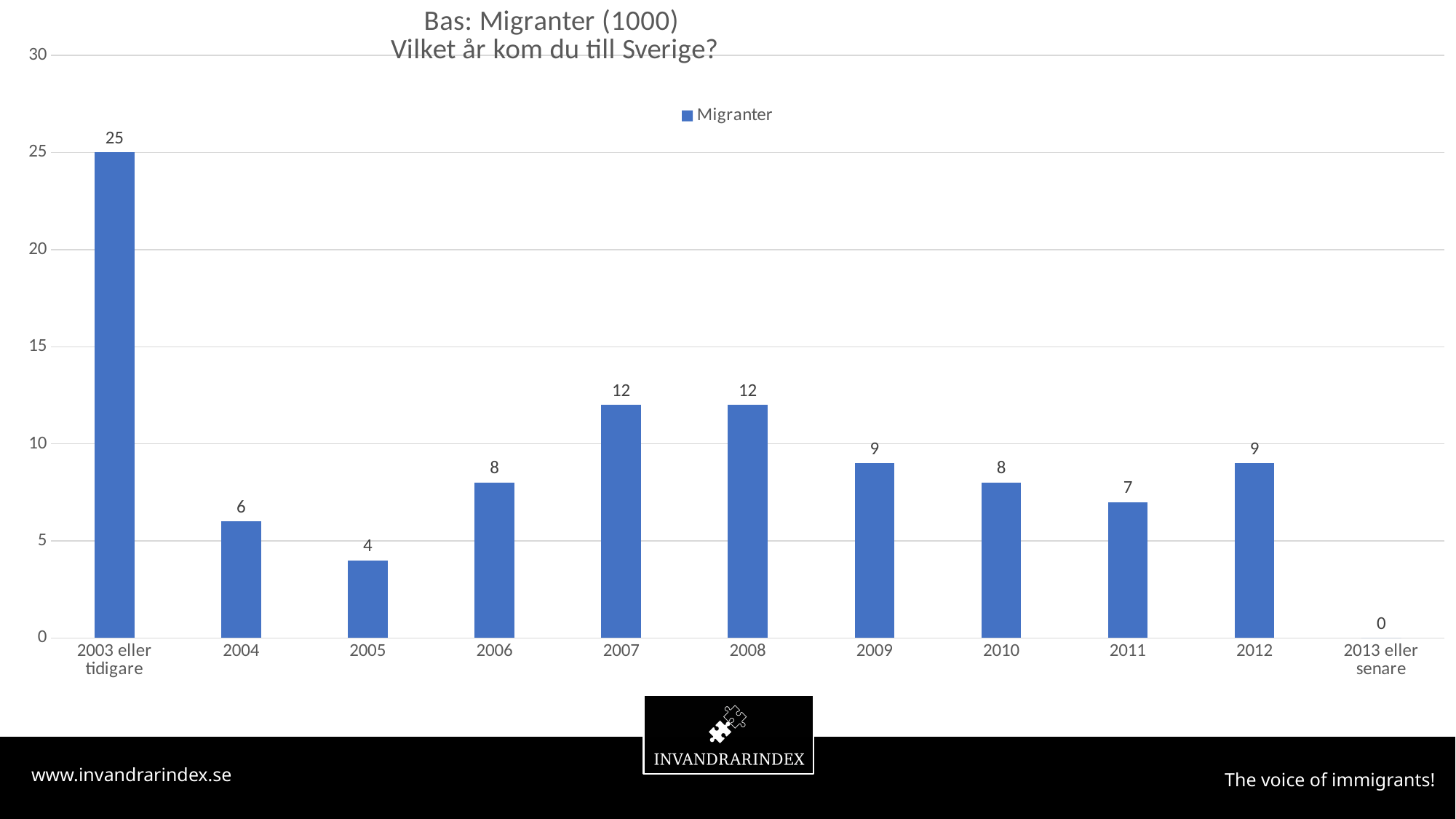
Which category has the highest value? 2003 eller tidigare Which category has the lowest value? 2013 eller senare What is the name of the series in the legend? Migranter Is the value for 2009 greater or less than 10? less What is the value for 2007? 12 Which is larger, the value for 2006 or the value for 2011? 2006 What is the value for 2003 eller tidigare? 25 What is the difference between the values for 2003 eller tidigare and 2005? 21 What kind of chart is shown? bar chart How many series does the legend list? 1 How many categories are shown on the x axis? 11 What is the value for 2013 eller senare? 0